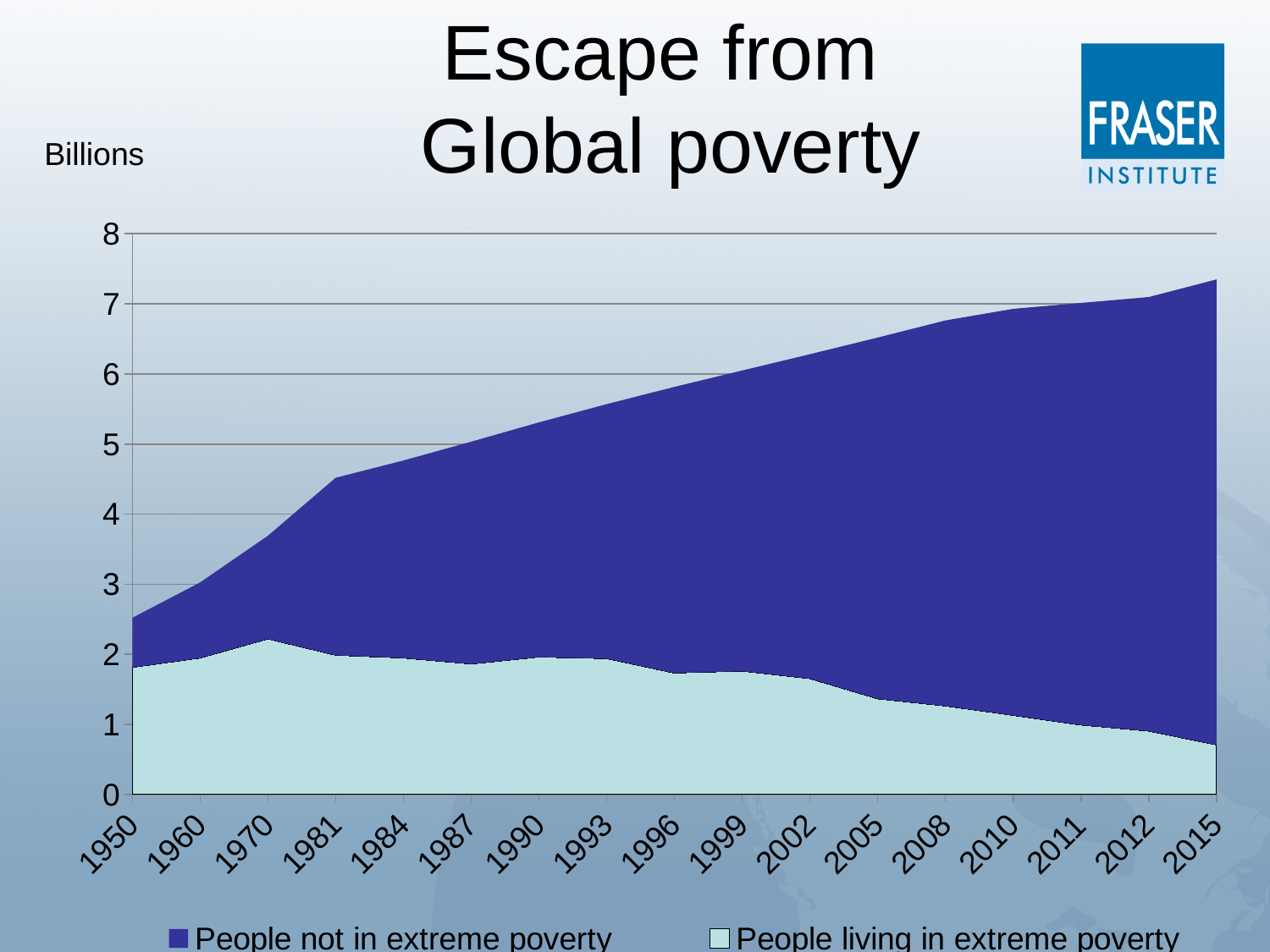
Is the total of both series in 2015 greater or less than 7? greater Does the number of people living in extreme poverty rise or fall between 1970 and 2015? Fall What kind of chart is shown on the slide? Stacked area chart What is the title of the chart? Escape from Global poverty Is the total of both series in 1950 greater or less than 3? less Is the value for people living in extreme poverty in 2015 greater or less than 1? less Does the total height of the stacked areas rise or fall from 1950 to 2015? Rise How many series does the legend list? 2 In which year is the number of people living in extreme poverty lowest? 2015 How many years are marked along the x axis? 17 What unit label is shown above the y axis? Billions Which is larger: the number of people living in extreme poverty in 1950 or in 2015? 1950